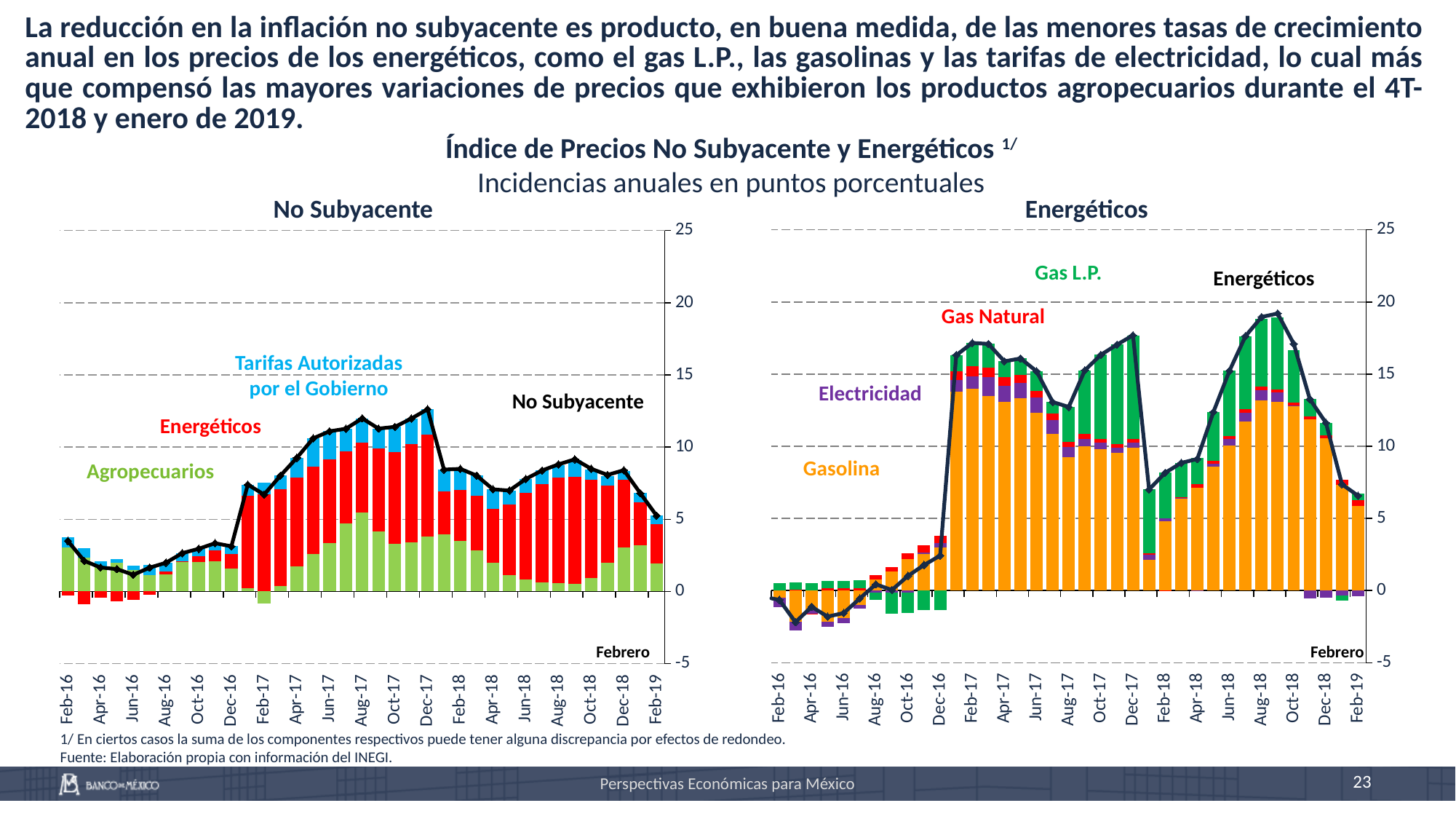
In the 'Energéticos' chart, is the value of the Energéticos line at Feb-16 greater or less than 0? less What is the main title shown above the two charts? Índice de Precios No Subyacente y Energéticos In the 'No Subyacente' chart on the left, how many bar components are labelled? 3 In the 'No Subyacente' chart, does the No Subyacente line rise or fall from Dec-17 to Feb-19? fall What kind of chart is the 'No Subyacente' chart on the left? Stacked bar chart with a line In the 'Energéticos' chart on the right, how many bar components are labelled? 4 In the 'Energéticos' chart, what colour represents Gasolina? Orange In the 'No Subyacente' chart, is the value of the No Subyacente line at Dec-17 greater or less than 10? greater In the 'Energéticos' chart, which is larger, the Energéticos line at Feb-17 or at Feb-18? Feb-17 In the 'No Subyacente' chart, is the value of the No Subyacente line at Feb-19 greater or less than 10? less In the 'Energéticos' chart, does the Energéticos line rise or fall from Aug-18 to Feb-19? fall